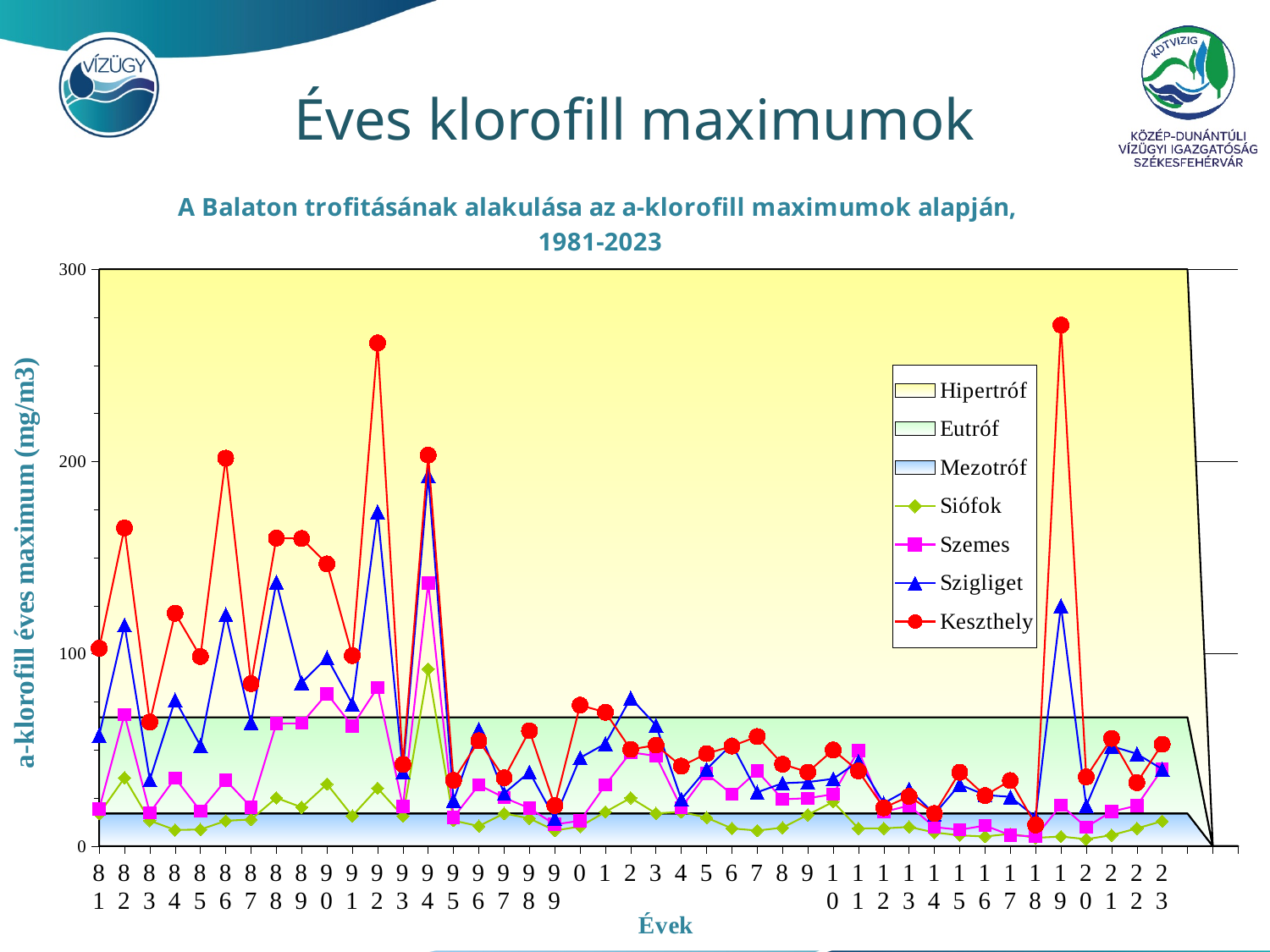
Is the value for Szigliget in 1992 greater or less than 100? greater What is the label of the y axis of the chart? a-klorofill éves maximum (mg/m3) Does the Keszthely value rise or fall from 1981 to 1982? rise Is the value for Siófok in 2020 greater or less than 100? less How many years are plotted along the x axis of the chart? 43 What kind of chart is shown on the slide? line chart In 1982, which is larger: the value for Szigliget or the value for Szemes? Szigliget Which series has the highest value in 2019? Keszthely Is the value for Keszthely in 1992 greater or less than 200? greater How many entries does the chart legend list? 7 Which series reaches the highest value anywhere on the chart? Keszthely